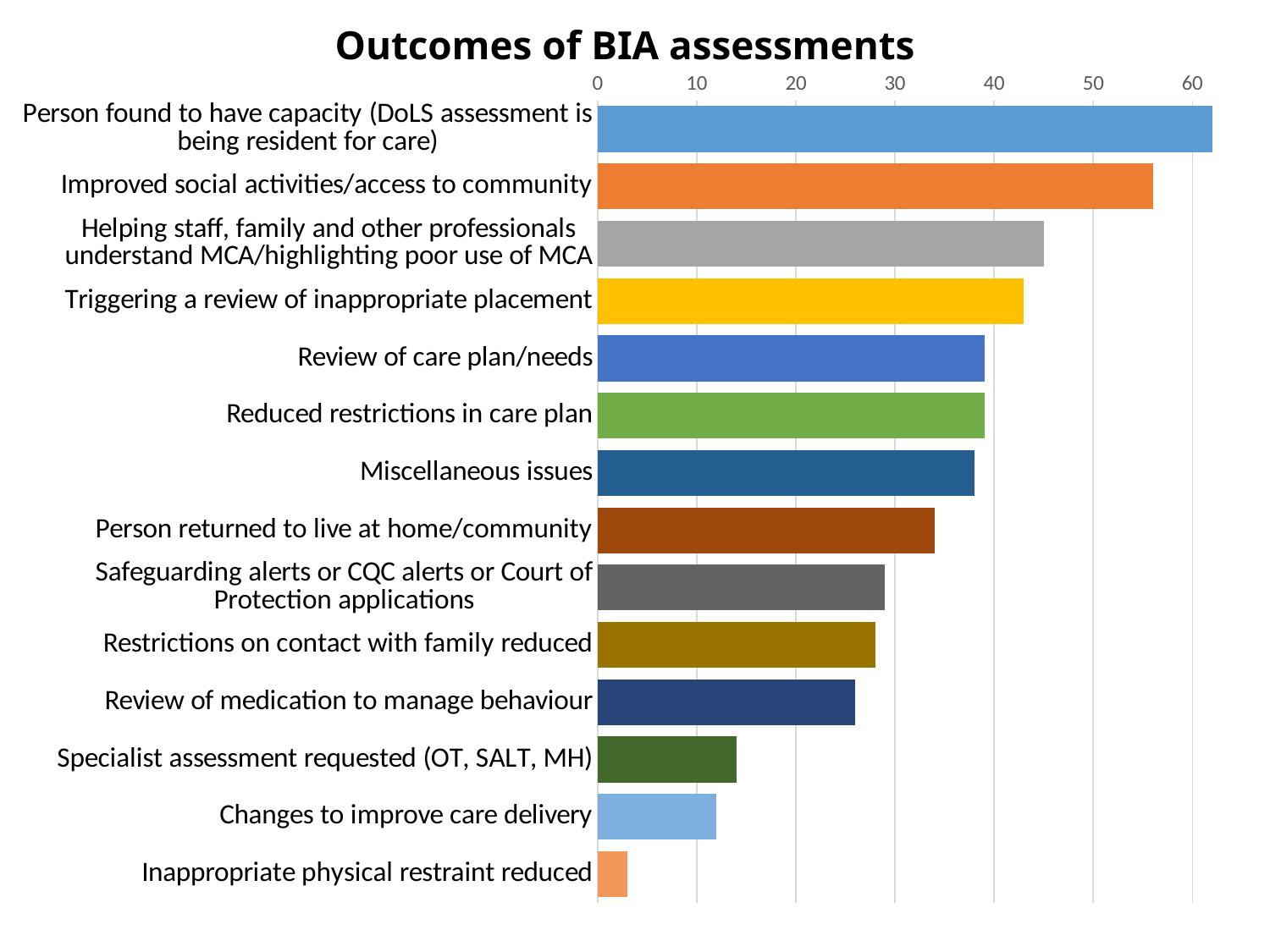
Is the value for 'Review of medication to manage behaviour' greater or less than 30? less What is the title of the chart? Outcomes of BIA assessments Which is larger: the value for 'Improved social activities/access to community' or for 'Triggering a review of inappropriate placement'? Improved social activities/access to community Is the value for 'Helping staff, family and other professionals understand MCA/highlighting poor use of MCA' greater or less than 40? greater Which outcome has the highest value? Person found to have capacity (DoLS assessment is being resident for care) What type of chart is shown on the slide? Bar chart Is the value for 'Improved social activities/access to community' greater or less than 50? greater Which outcome has the lowest value? Inappropriate physical restraint reduced How many outcome categories are plotted in the chart? 14 Which is larger: the value for 'Miscellaneous issues' or for 'Person returned to live at home/community'? Miscellaneous issues